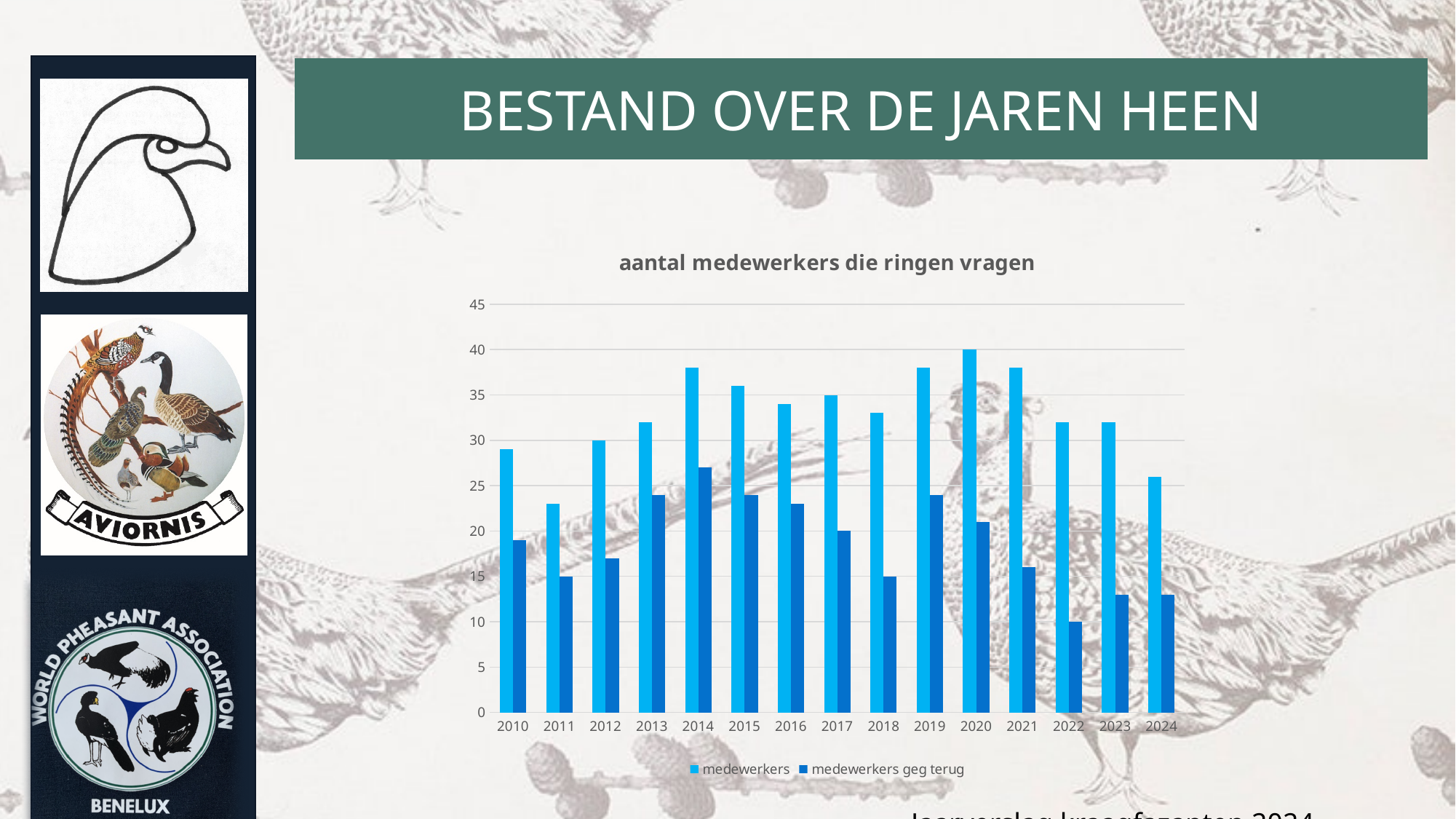
Which is larger: medewerkers geg terug in 2014 or in 2024? 2014 How many years are shown on the x axis of the chart? 15 What kind of chart is shown on the slide? bar chart Is the value for medewerkers geg terug in 2021 greater or less than 20? less What is the title of the chart? aantal medewerkers die ringen vragen In which year is the value for medewerkers the highest? 2020 Is the value for medewerkers in 2024 greater or less than 30? less Is the value for medewerkers in 2014 greater or less than 35? greater What is the value for medewerkers geg terug in 2022? 10 What is the value for medewerkers in 2020? 40 How many series does the legend list? 2 In which year is the value for medewerkers geg terug the lowest? 2022